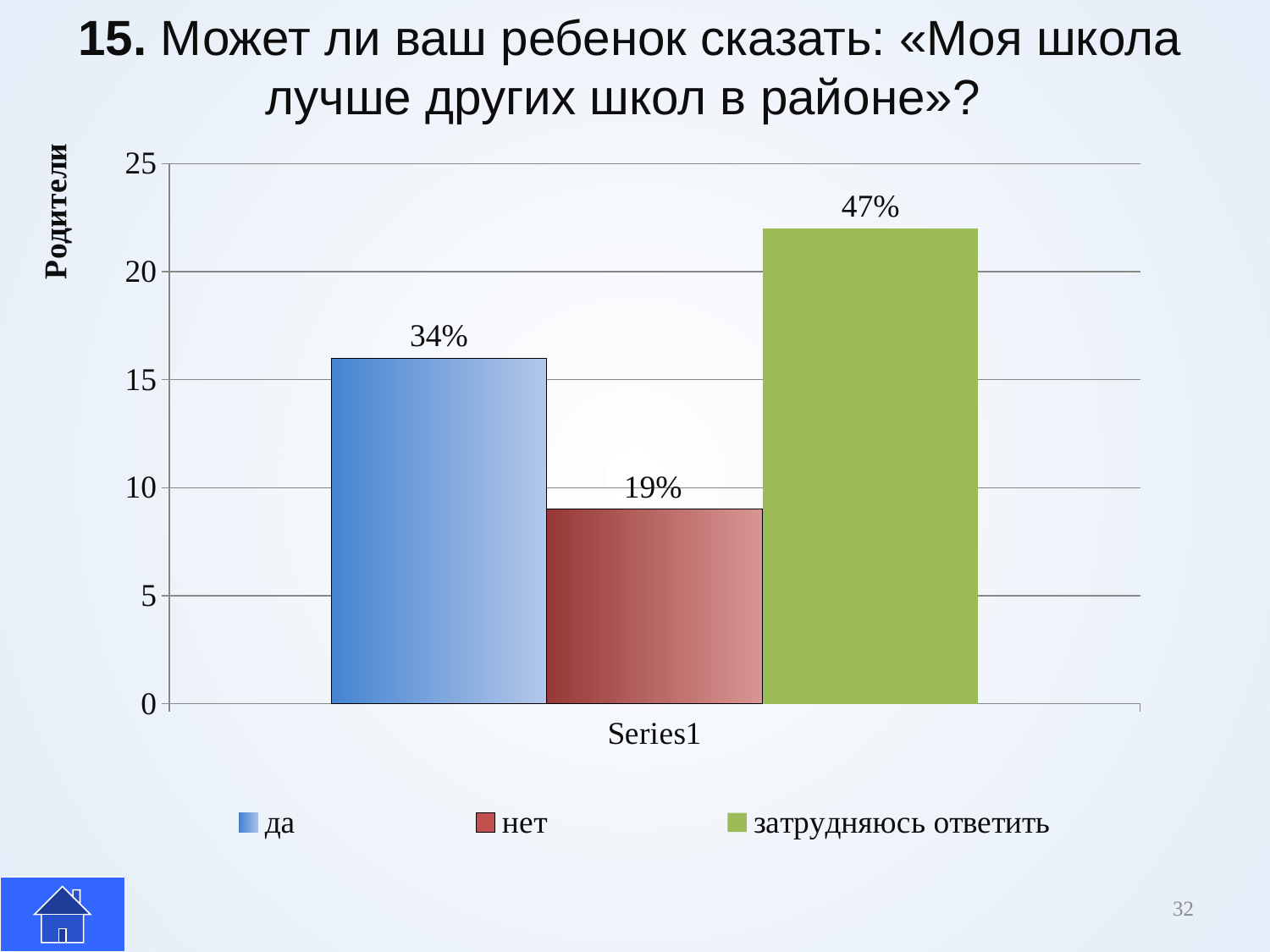
What is the difference in percentage points between the labels for «затрудняюсь ответить» and «да»? 13% What type of chart is shown on the slide? bar chart What data label is shown on the bar for «нет»? 19% Which answer option has the highest bar? затрудняюсь ответить What data label is shown on the bar for «да»? 34% How many bars are plotted in the chart? 3 Is the value for «да» on the vertical axis greater or less than 15? greater Which is larger, the bar for «да» or the bar for «нет»? да Which answer option has the lowest bar? нет What data label is shown on the bar for «затрудняюсь ответить»? 47% What is the difference in percentage points between the labels for «да» and «нет»? 15% Is the value for «нет» on the vertical axis greater or less than 10? less